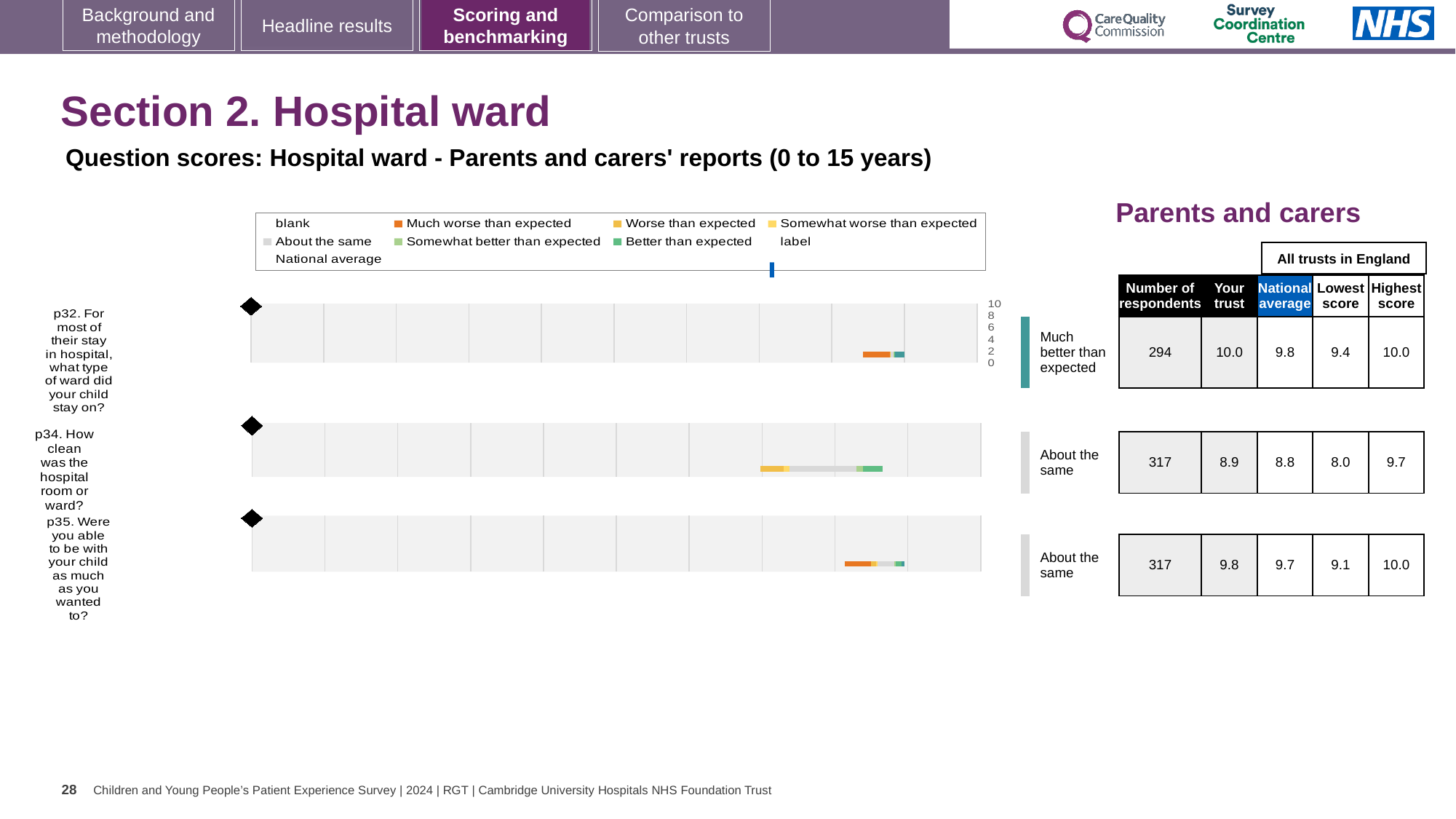
How many respondents answered p35 (were you able to be with your child as much as you wanted to)? 317 Is the 'Your trust' score for p35 larger or smaller than the national average for p35? larger What kind of chart is shown on the slide? bar chart What is the national average score for p34 (how clean was the hospital room or ward)? 8.8 What is the difference between the highest score and the lowest score across all trusts in England for p34? 1.7 What colour is used in the legend for 'Much worse than expected'? orange What benchmark category is shown for p32? Much better than expected Which question has the lowest 'Your trust' score? p34. How clean was the hospital room or ward? Which question has the highest 'Your trust' score? p32. For most of their stay in hospital, what type of ward did your child stay on? What is the 'Your trust' score for p32 (what type of ward did your child stay on)? 10.0 How many questions (categories) are plotted in the chart? 3 How many entries does the chart legend list? 9